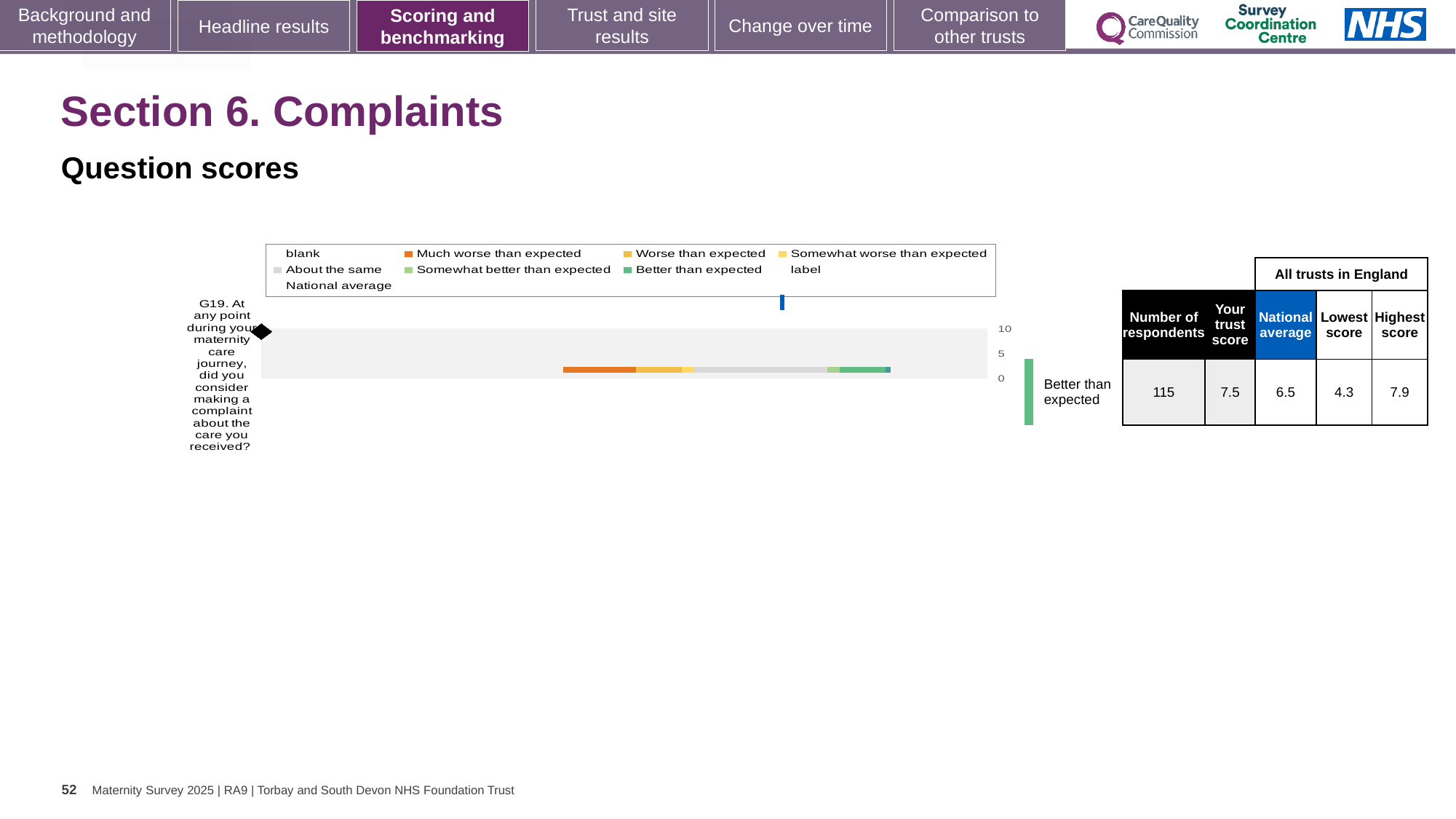
What is the highest score among all trusts in England for question G19? 7.9 What kind of chart is used to show the question score for G19? bar chart How many respondents answered question G19? 115 What is the difference between the highest and lowest scores among all trusts in England for question G19? 3.6 How many questions are plotted in the chart? 1 Which is larger for question G19: the trust score or the national average? trust score What is the difference between the trust score and the national average for question G19? 1.0 Which benchmark category is the trust's result for question G19 labelled as? Better than expected What is the trust's score for question G19 shown in the table beside the chart? 7.5 What is the national average score for question G19? 6.5 What is the lowest score among all trusts in England for question G19? 4.3 Which question code is plotted in the chart? G19